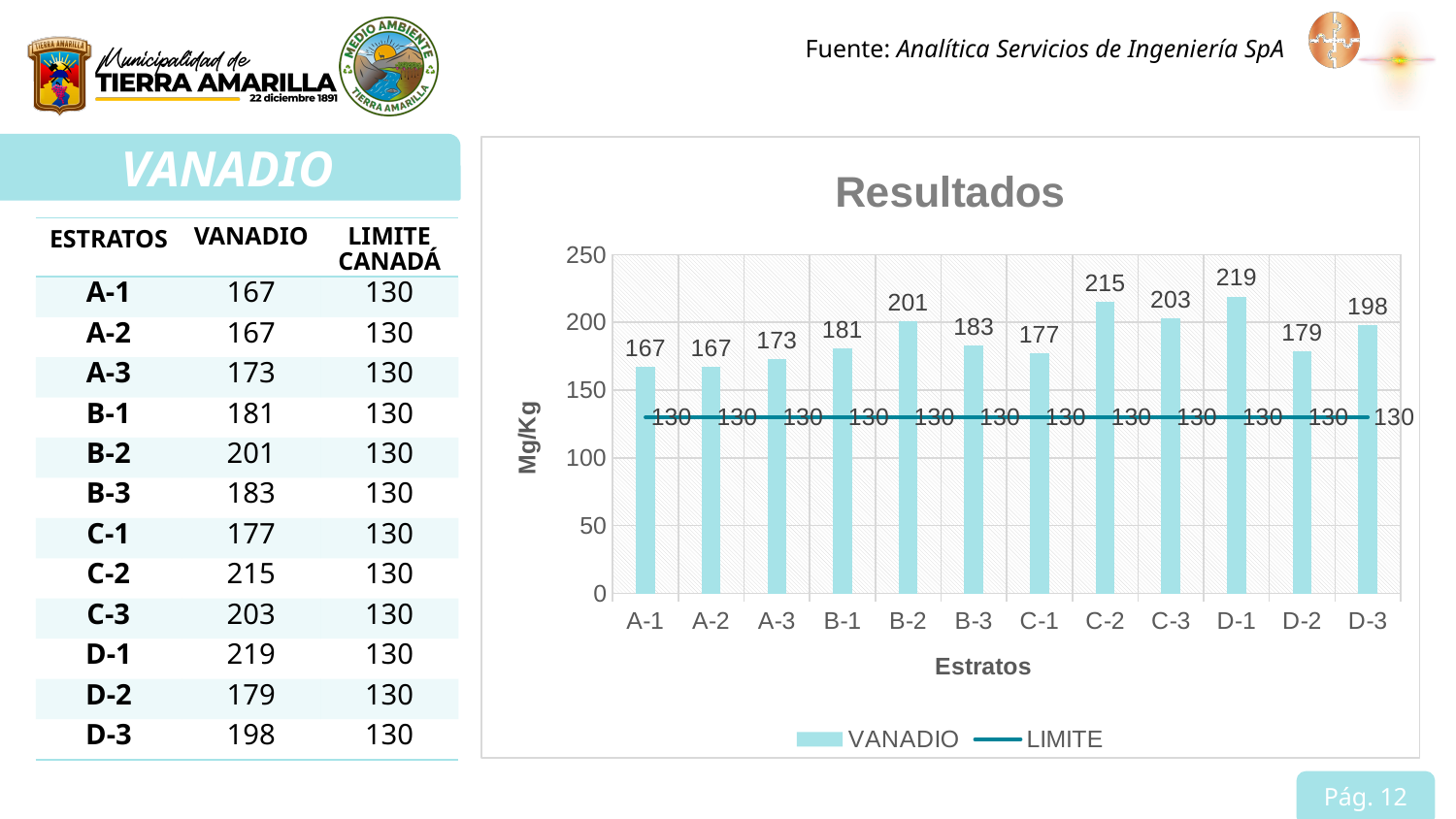
What is the difference between the VANADIO value for D-3 and the LIMITE value in the Resultados chart? 68 What kind of chart is the Resultados chart? combination bar and line chart What is the label of the y axis in the Resultados chart? Mg/Kg How many categories are shown on the x axis of the Resultados chart? 12 How many series does the legend of the Resultados chart list? 2 What is the VANADIO value for C-2 in the Resultados chart? 215 What is the VANADIO value for B-1 in the Resultados chart? 181 What is the LIMITE value shown for every category in the Resultados chart? 130 Which is larger in the Resultados chart, the VANADIO value for B-2 or for C-3? C-3 What is the difference between the VANADIO values for D-1 and A-1 in the Resultados chart? 52 Which category has the highest VANADIO value in the Resultados chart? D-1 What is the title of the chart on the slide? Resultados